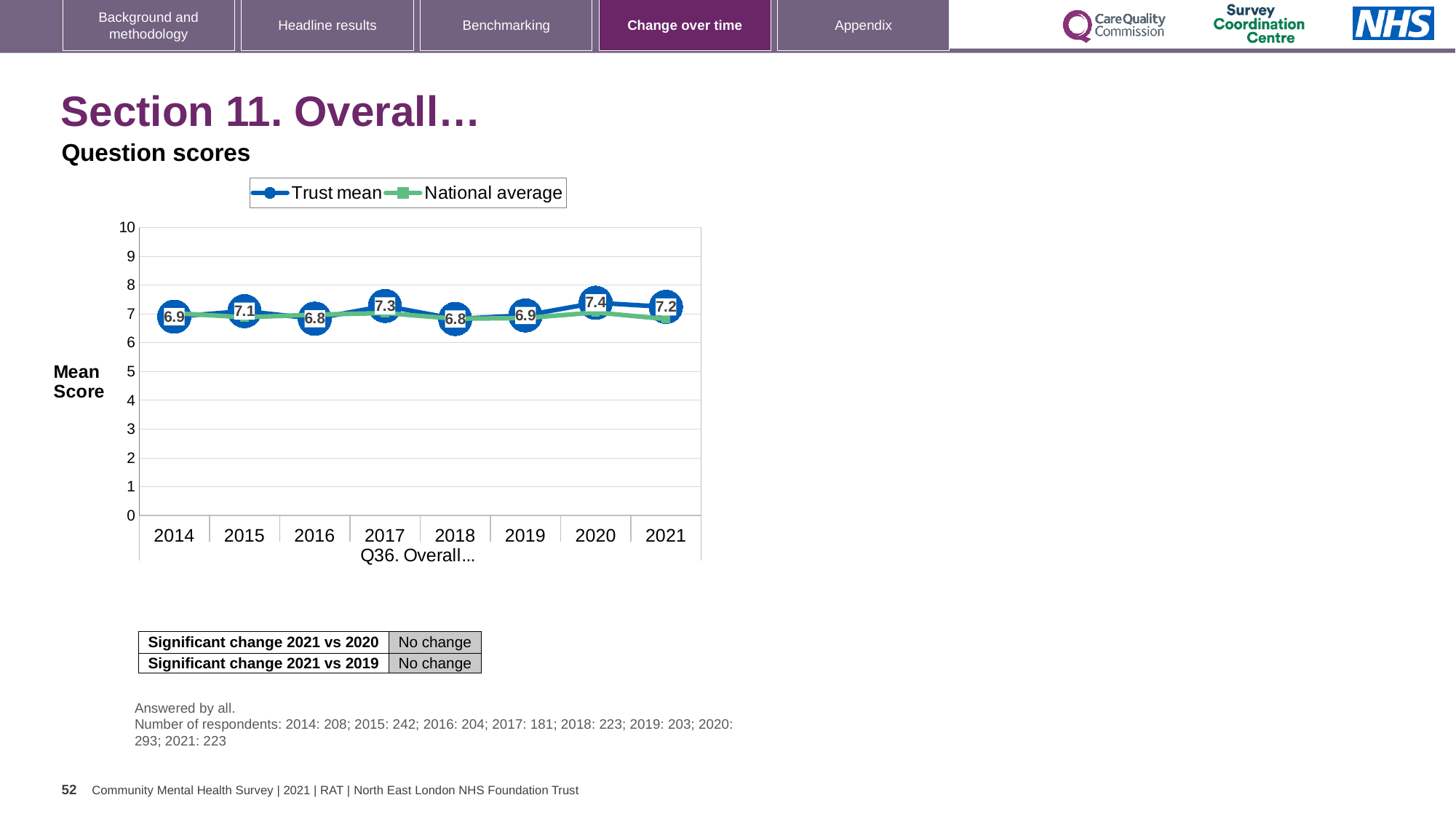
How many years are shown on the x axis? 8 What is the difference between the Trust mean in 2020 and in 2021? 0.2 What is the Trust mean for 2017? 7.3 In which year is the Trust mean highest? 2020 How many series does the legend list? 2 What is the Trust mean for 2020? 7.4 Did the Trust mean rise or fall from 2020 to 2021? Fall What is the Trust mean for 2021? 7.2 What is the label on the y axis? Mean Score What kind of chart is shown? Line chart Is the National average for 2021 greater or less than 5? greater Is the Trust mean higher in 2017 or in 2018? 2017